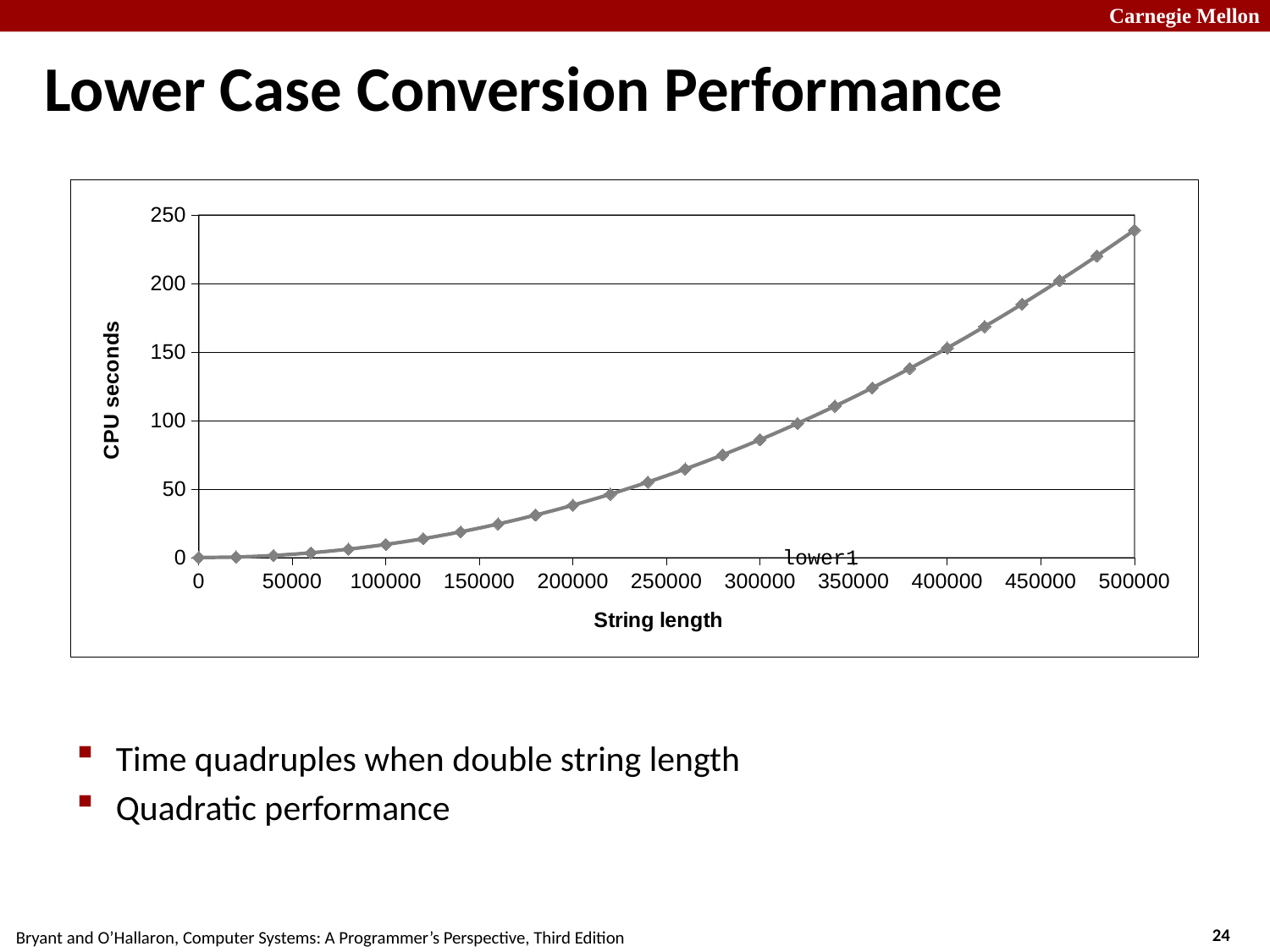
Do the CPU seconds rise or fall as string length increases? rise Is the CPU time at a string length of 500000 greater or less than 200? greater What kind of chart is shown on the slide? line chart Is the CPU time at a string length of 100000 greater or less than 50? less At which string length is the CPU time lowest? 0 At which string length is the CPU time highest? 500000 What is the title of the x axis of the chart? String length Is the CPU time at a string length of 300000 greater or less than 100? less Which has the larger CPU time: a string length of 100000 or a string length of 400000? 400000 What is the title of the y axis of the chart? CPU seconds